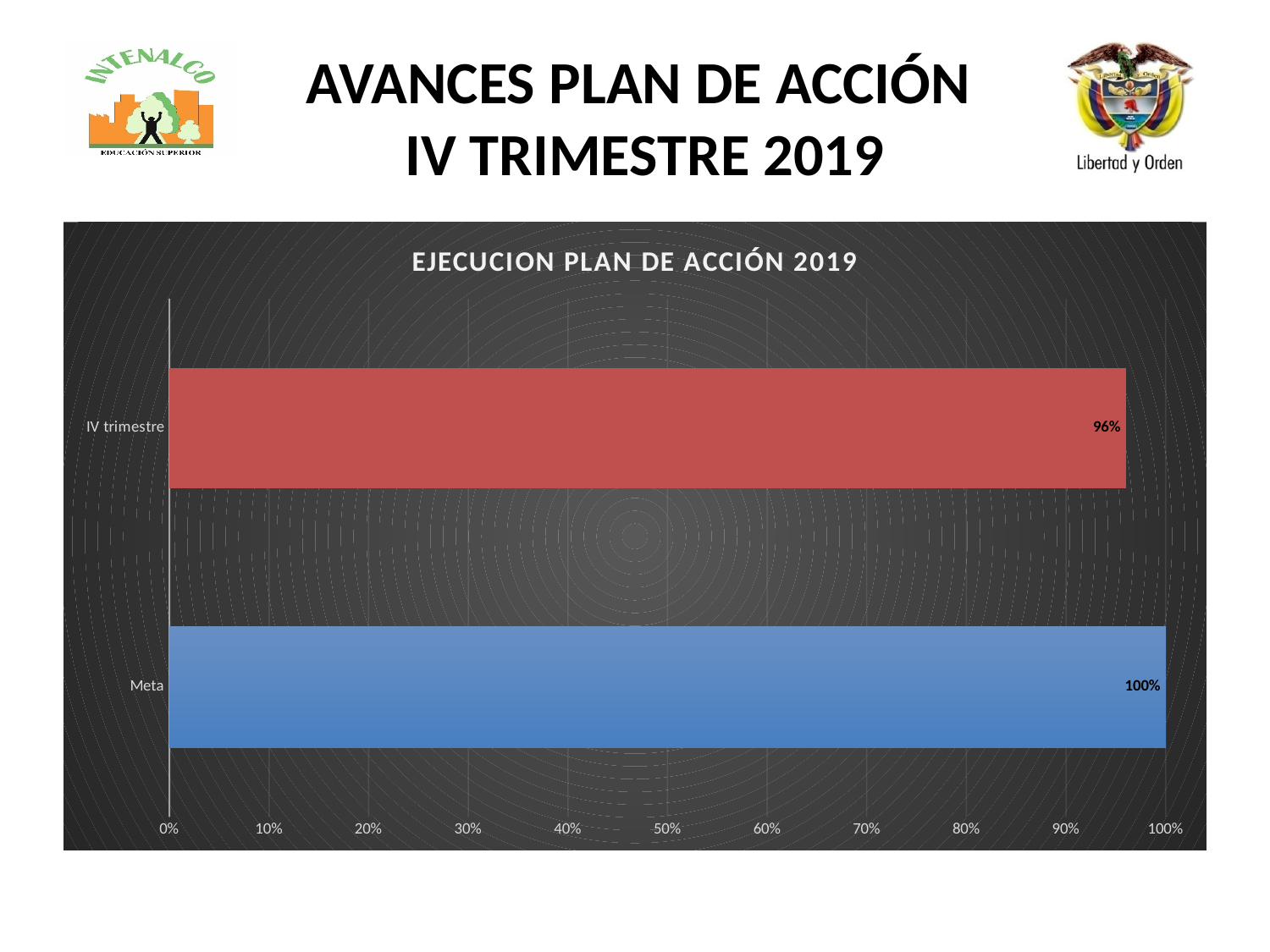
What is the value for Meta? 100% Is the value for IV trimestre greater or less than 90%? greater What is the difference between the value for Meta and the value for IV trimestre? 4% What is the value for IV trimestre? 96% Which is larger, the value for Meta or the value for IV trimestre? Meta What is the title of the chart? EJECUCION PLAN DE ACCIÓN 2019 Which category has the lowest value? IV trimestre What kind of chart is shown on the slide? bar chart What colour is the bar for Meta? blue Which category has the highest value? Meta How many categories are shown in the chart? 2